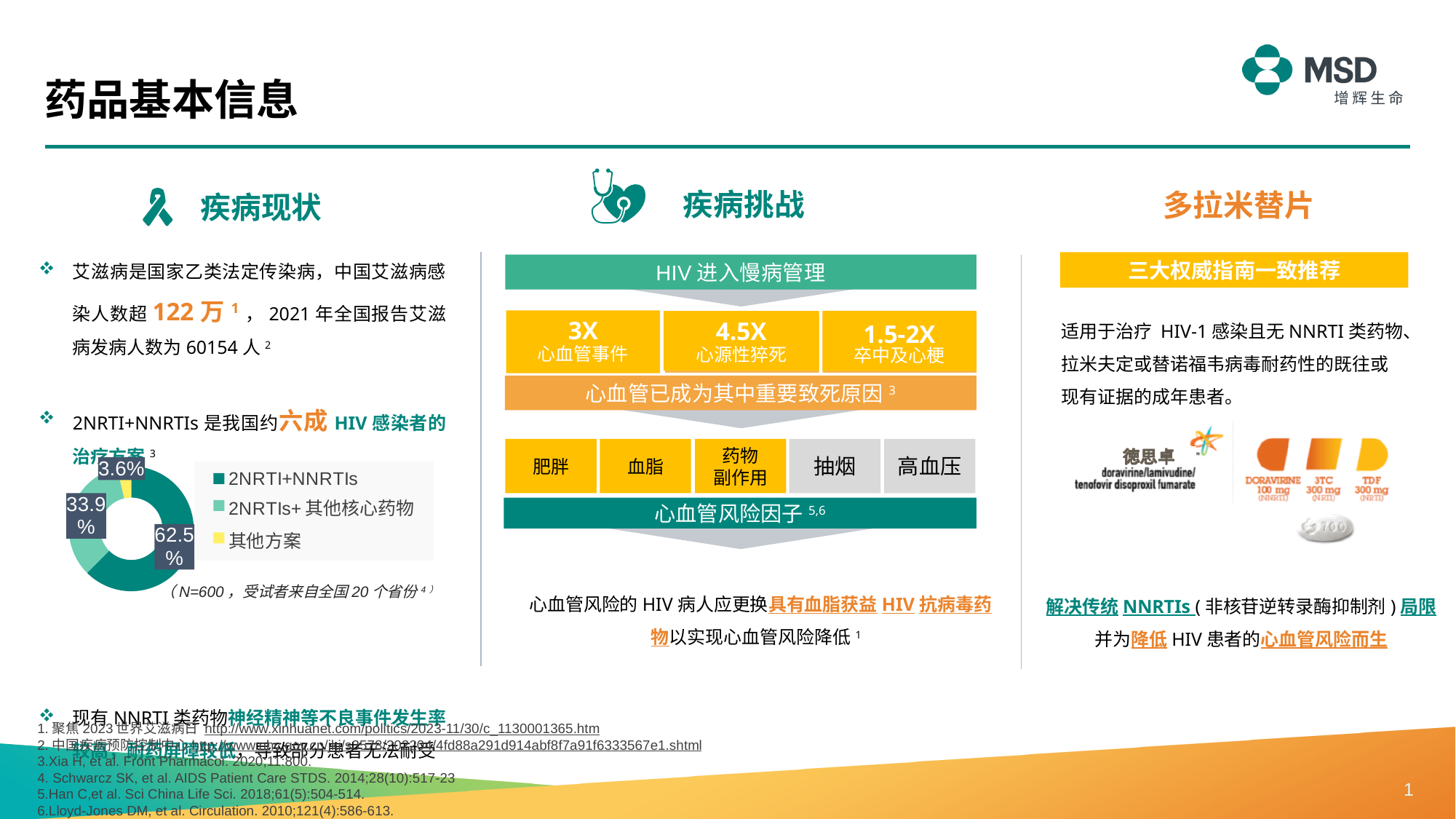
Which category has the smallest slice in the doughnut chart? 其他方案 In the doughnut chart, which is larger: the share for 2NRTIs+其他核心药物 or the share for 其他方案? 2NRTIs+其他核心药物 How many entries does the legend of the doughnut chart list? 3 In the doughnut chart, what is the difference between the shares of 2NRTI+NNRTIs and 2NRTIs+其他核心药物? 28.6% In the doughnut chart, what share is shown for 其他方案? 3.6% In the doughnut chart, what share is shown for 2NRTI+NNRTIs? 62.5% What kind of chart is shown under the 疾病现状 section? Doughnut (pie) chart What sample size (N) is noted below the doughnut chart? N=600 In the doughnut chart, what share is shown for 2NRTIs+其他核心药物? 33.9% Which category has the largest slice in the doughnut chart? 2NRTI+NNRTIs In the doughnut chart, what is the combined share of 2NRTIs+其他核心药物 and 其他方案? 37.5% How many categories does the doughnut chart show? 3